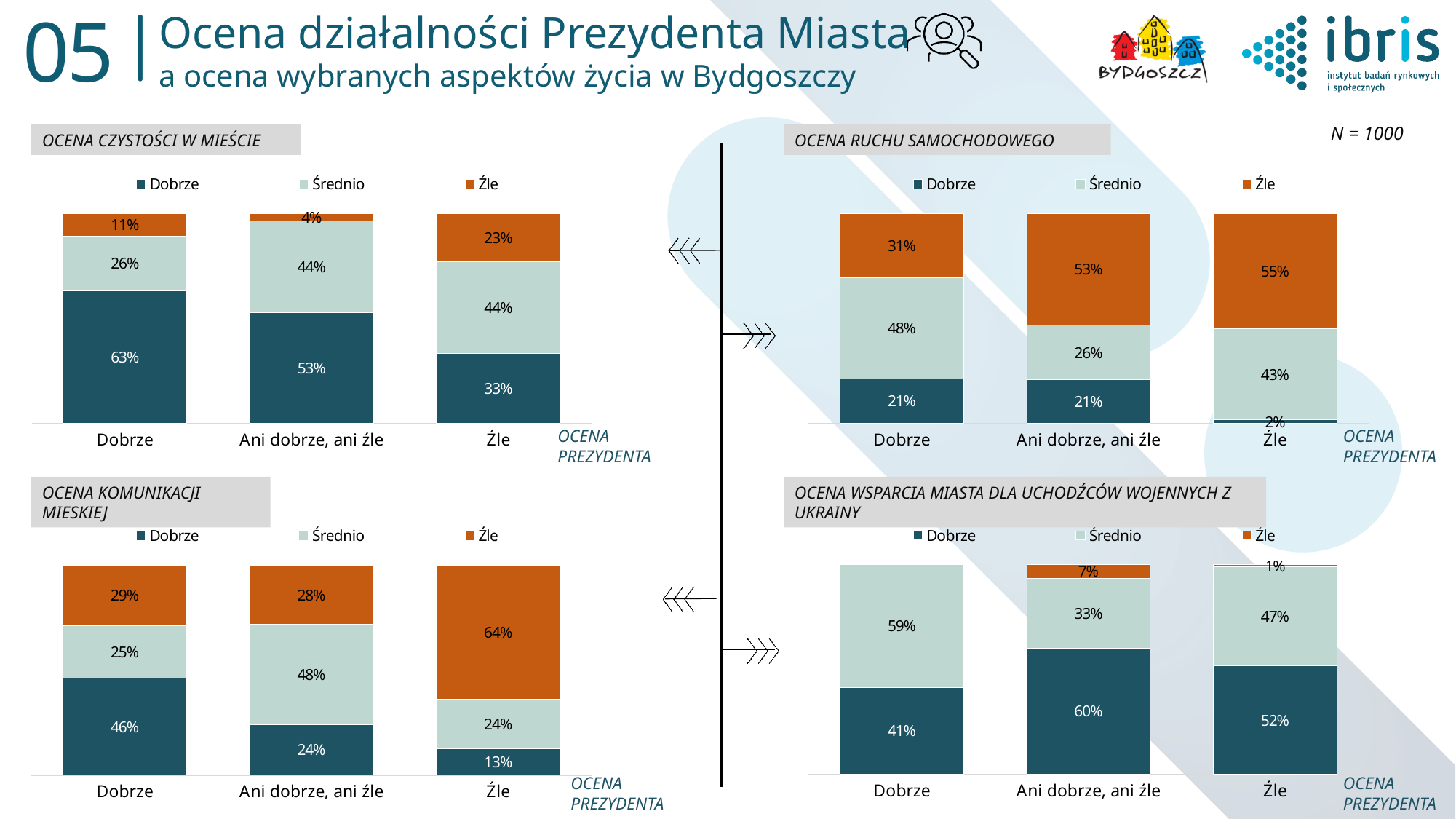
In the 'OCENA KOMUNIKACJI MIESKIEJ' chart, what is the 'Źle' share for the 'Źle' category? 64% In the 'OCENA RUCHU SAMOCHODOWEGO' chart, what is the 'Źle' share for the 'Ani dobrze, ani źle' category? 53% In the 'OCENA CZYSTOŚCI W MIEŚCIE' chart, what is the 'Źle' share for the 'Źle' category? 23% In the 'OCENA WSPARCIA MIASTA DLA UCHODŹCÓW WOJENNYCH Z UKRAINY' chart, what is the 'Dobrze' share for the 'Ani dobrze, ani źle' category? 60% In the 'OCENA KOMUNIKACJI MIESKIEJ' chart, which category has the lowest 'Dobrze' share? Źle In the 'OCENA RUCHU SAMOCHODOWEGO' chart, which category has the highest 'Źle' share? Źle What type of chart is the 'OCENA RUCHU SAMOCHODOWEGO' chart? Stacked bar chart How many series does the legend of the 'OCENA CZYSTOŚCI W MIEŚCIE' chart list? 3 In the 'OCENA KOMUNIKACJI MIESKIEJ' chart, is the 'Dobrze' share larger for 'Dobrze' or for 'Ani dobrze, ani źle'? Dobrze In the 'OCENA RUCHU SAMOCHODOWEGO' chart, what is the difference between the 'Średnio' shares for 'Dobrze' and 'Ani dobrze, ani źle'? 22% In the 'OCENA CZYSTOŚCI W MIEŚCIE' chart, what is the 'Dobrze' share for the 'Dobrze' category? 63% In the 'OCENA WSPARCIA MIASTA DLA UCHODŹCÓW WOJENNYCH Z UKRAINY' chart, what is the 'Średnio' share for the 'Dobrze' category? 59%